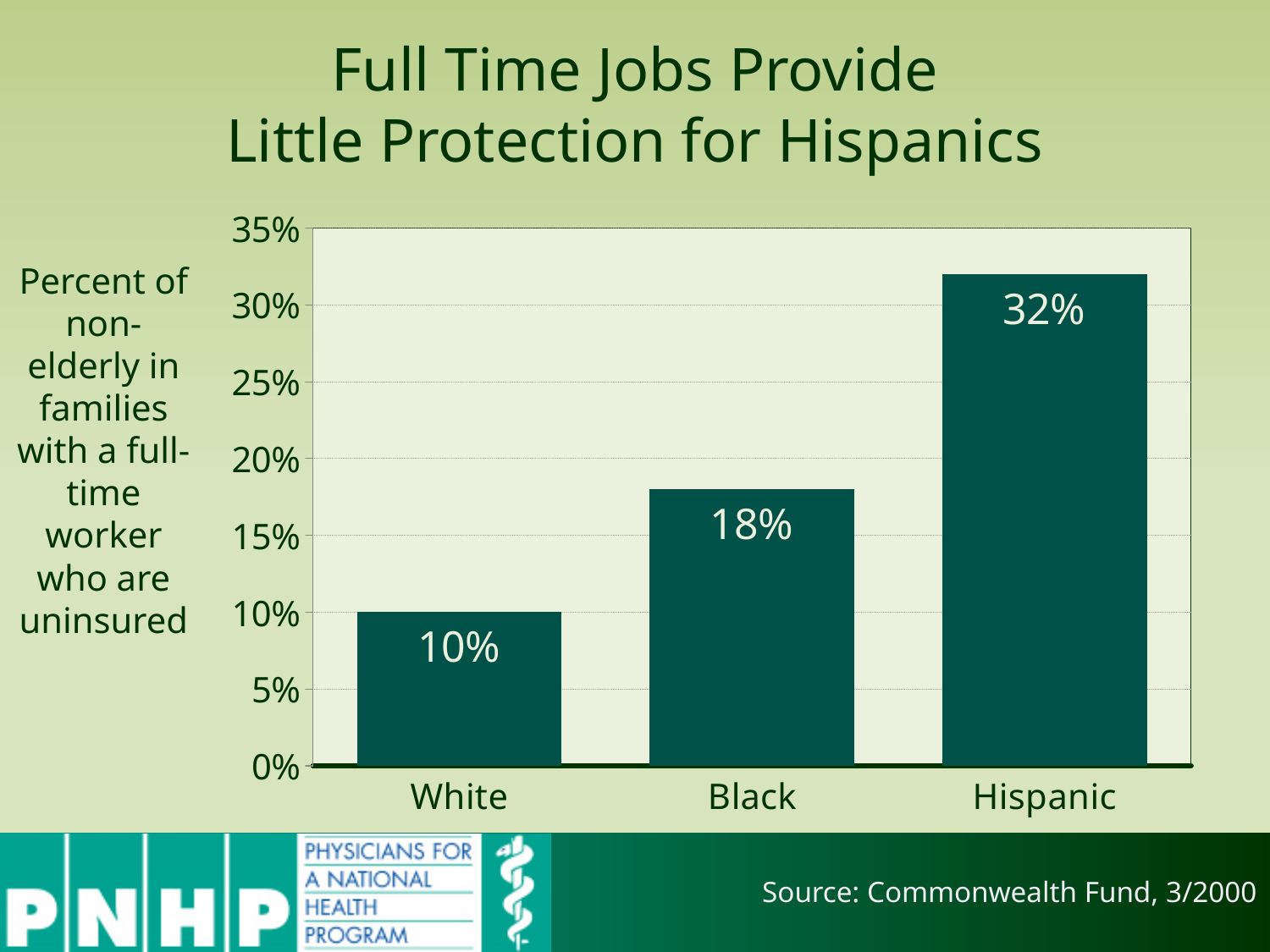
What is the value for White? 10% How many categories are shown on the x axis? 3 What is the difference between the values for Hispanic and Black? 14% What is the value for Hispanic? 32% Which category has the highest value? Hispanic What is the difference between the values for Black and White? 8% Do the values rise or fall from White to Hispanic along the x axis? Rise What is the value for Black? 18% What kind of chart is shown on the slide? Bar chart Is the value for Hispanic greater or less than 30%? greater Which is larger, the value for Black or the value for White? Black Which category has the lowest value? White